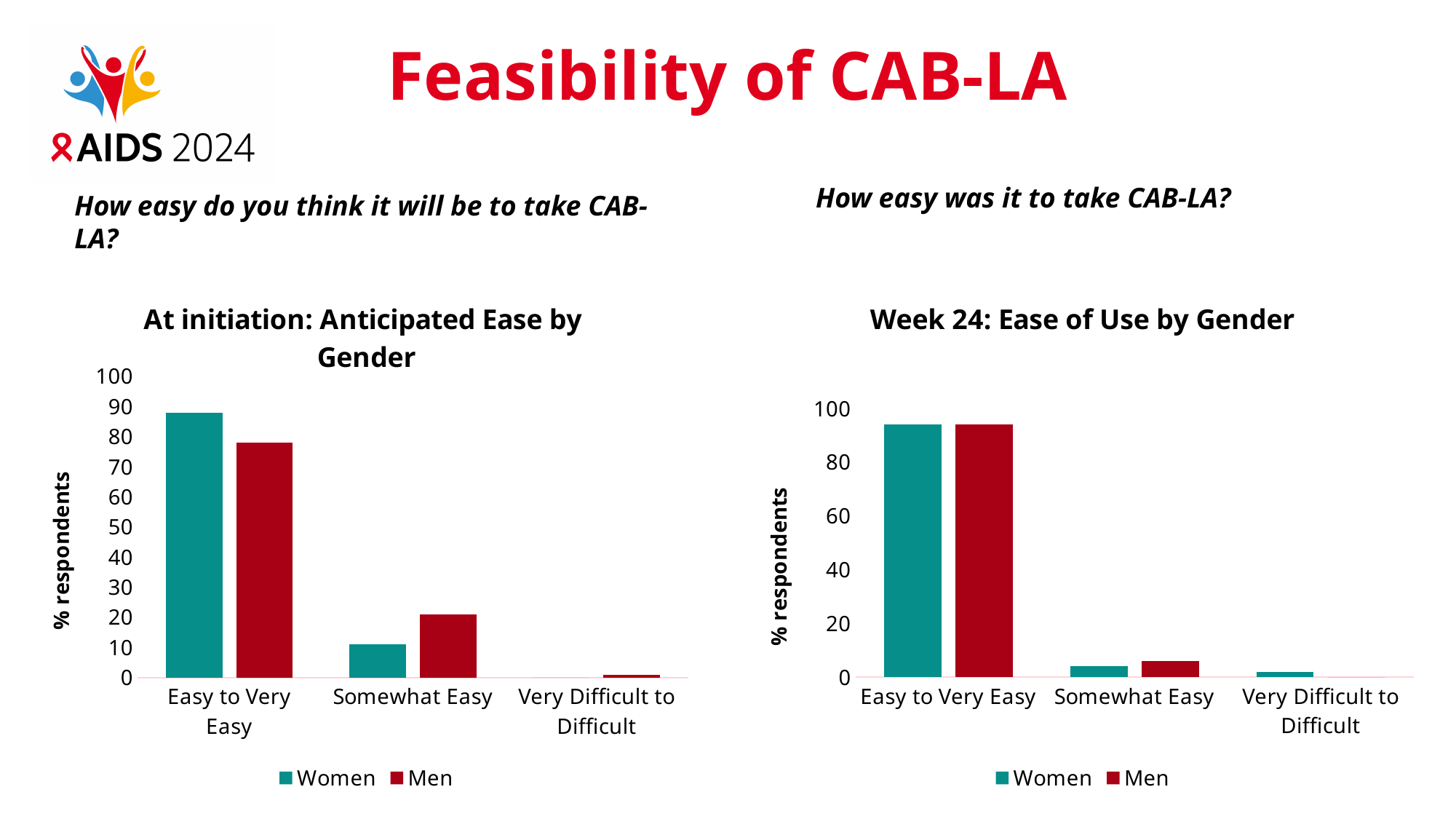
In the 'At initiation: Anticipated Ease by Gender' chart, is the value for Men in 'Easy to Very Easy' greater or less than 70? greater In the 'Week 24: Ease of Use by Gender' chart, which category has the highest value for Women? Easy to Very Easy In the 'At initiation: Anticipated Ease by Gender' chart, how many categories are shown on the x axis? 3 In the 'Week 24: Ease of Use by Gender' chart, is the value for Men in 'Somewhat Easy' greater or less than 20? less In the 'At initiation: Anticipated Ease by Gender' chart, which is larger for 'Somewhat Easy', Women or Men? Men In the 'At initiation: Anticipated Ease by Gender' chart, which is larger for 'Easy to Very Easy', Women or Men? Women In the 'At initiation: Anticipated Ease by Gender' chart, is the value for Women in 'Easy to Very Easy' greater or less than 80? greater In the 'At initiation: Anticipated Ease by Gender' chart, how many series does the legend list? 2 What is the y-axis label of the 'Week 24: Ease of Use by Gender' chart? % respondents What kind of chart is the 'At initiation: Anticipated Ease by Gender' chart? bar chart